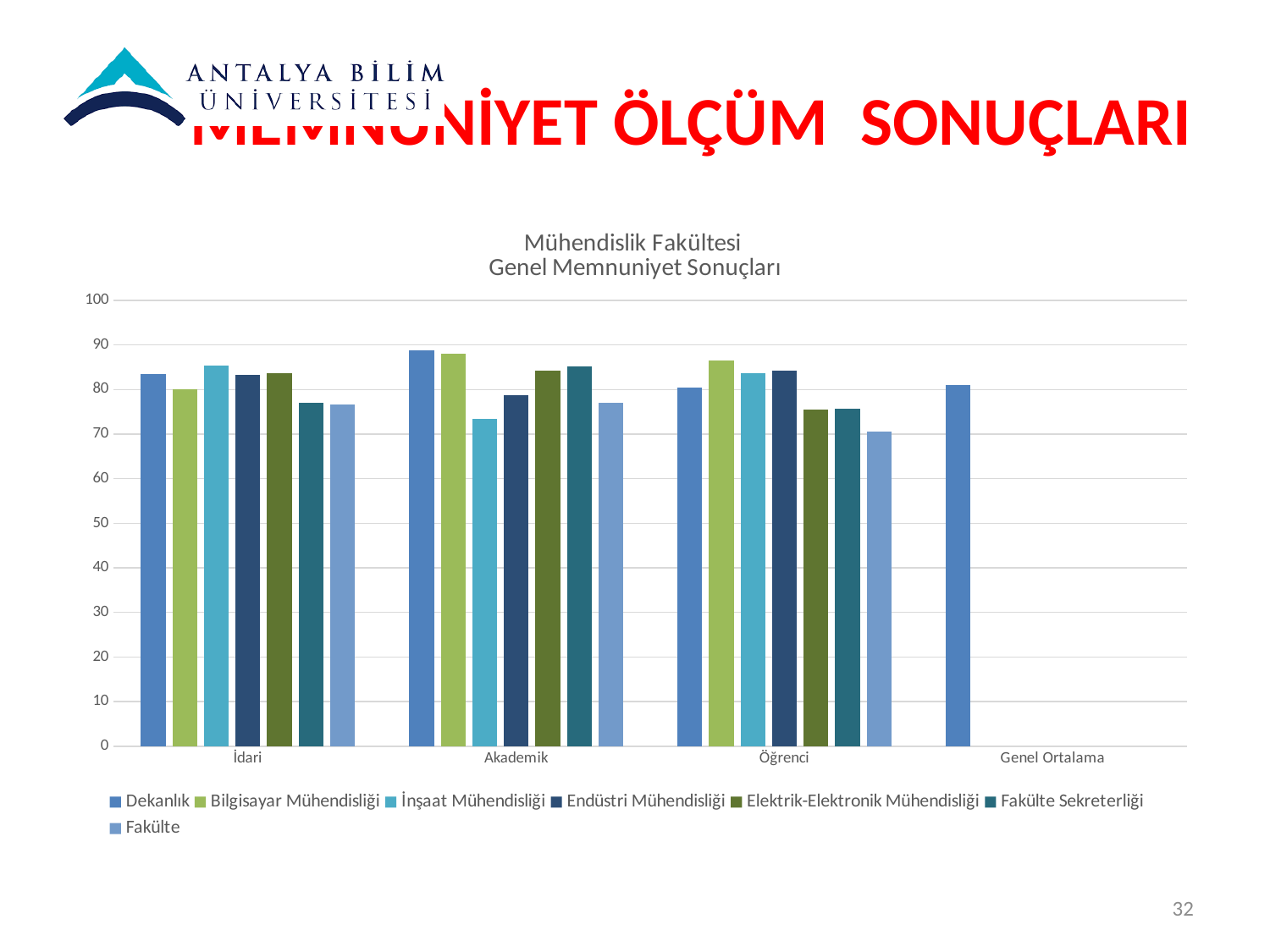
In the Akademik category, which is larger: the value for Dekanlık or the value for İnşaat Mühendisliği? Dekanlık How many series does the chart's legend list? 7 Is the value for İnşaat Mühendisliği in the Akademik category greater or less than 80? less Which series has the lowest value in the Öğrenci category? Fakülte What is the title of the chart? Mühendislik Fakültesi Genel Memnuniyet Sonuçları Is the value for Fakülte in the Öğrenci category greater or less than 80? less Which category on the x axis has only a single bar plotted? Genel Ortalama What kind of chart is shown on the slide? bar chart Is the value for Dekanlık in the Akademik category greater or less than 80? greater How many categories are shown on the x axis of the chart? 4 Which series has the lowest value in the Akademik category? İnşaat Mühendisliği